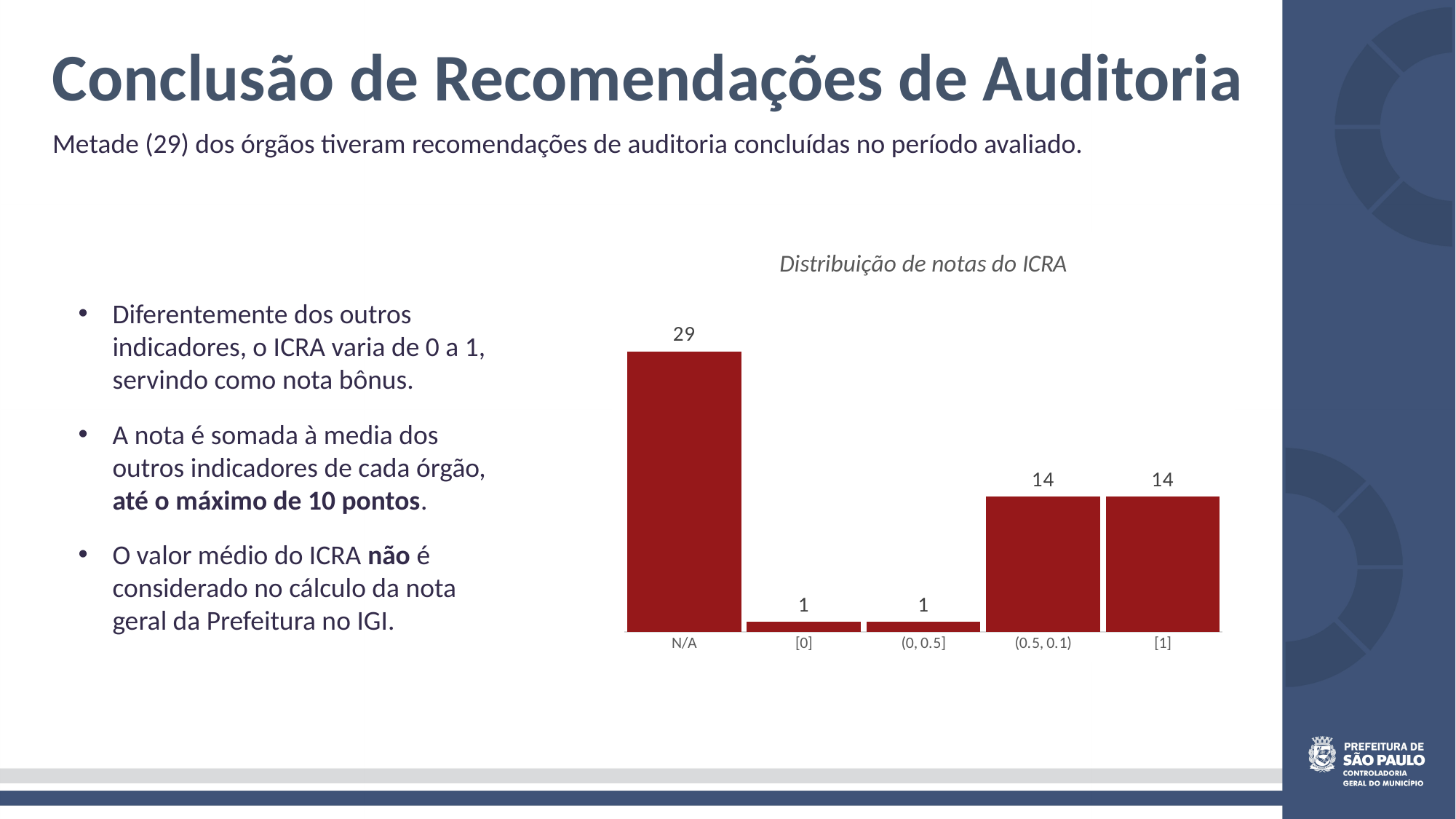
Which category has the highest value? N/A What is the title of the chart? Distribuição de notas do ICRA What is the value for the [0] category? 1 Which is larger, the value for N/A or the value for (0.5, 0.1)? N/A What is the value for the [1] category? 14 What kind of chart is shown on the slide? bar chart What is the difference between the (0.5, 0.1) value and the (0, 0.5) value? 13 What is the value for the N/A category? 29 What is the value for the (0.5, 0.1) category? 14 What is the difference between the N/A value and the [1] value? 15 How many categories are shown on the x axis? 5 What is the total of all the values shown in the chart? 59